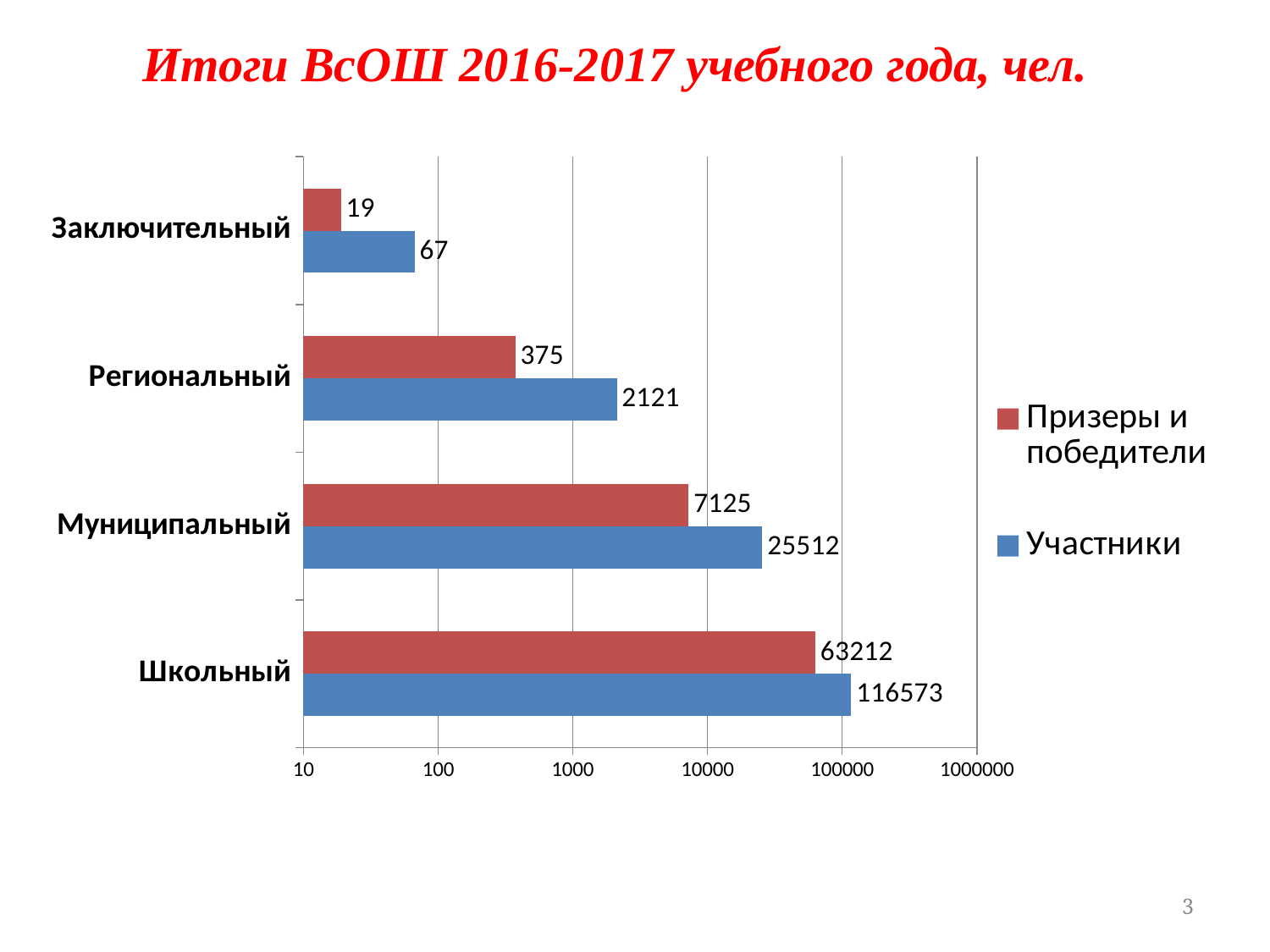
Which stage has the lowest value for Призеры и победители? Заключительный Which is larger: Участники at the Региональный stage or Призеры и победители at the Муниципальный stage? Призеры и победители at the Муниципальный stage What is the value for Участники at the Школьный stage? 116573 What is the value for Призеры и победители at the Муниципальный stage? 7125 What kind of chart is shown on the slide? Bar chart What is the value for Призеры и победители at the Региональный stage? 375 What is the difference between Участники and Призеры и победители at the Муниципальный stage? 18387 How many series does the legend list? 2 What colour are the bars for the Участники series? Blue Which stage has the highest value for Участники? Школьный How many stages (categories) are shown on the chart? 4 What is the value for Участники at the Заключительный stage? 67